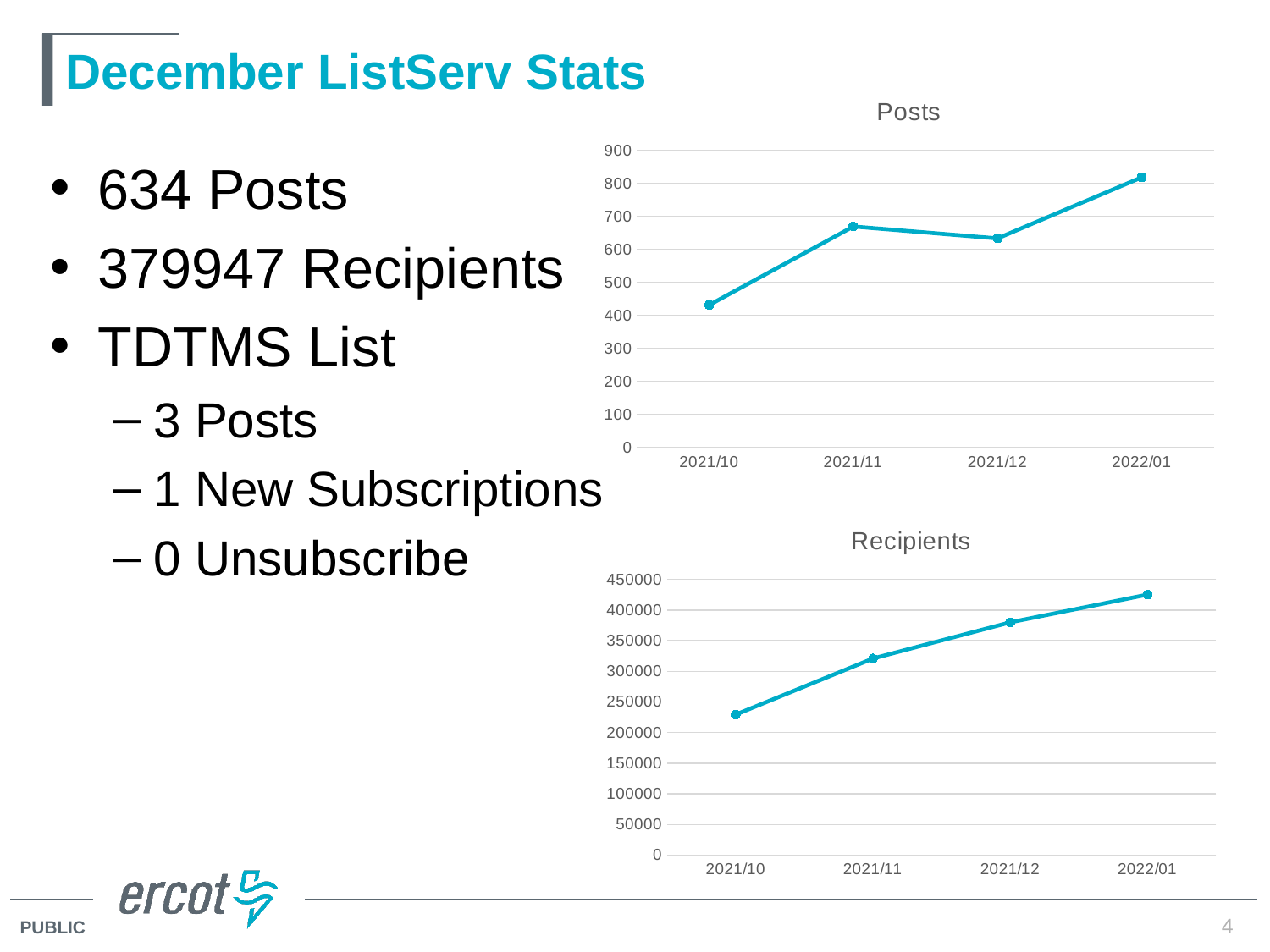
How many data points are plotted in the Recipients chart? 4 What kind of chart is the Recipients chart? line chart What kind of chart is the Posts chart? line chart In the Posts chart, which month has the lowest number of posts? 2021/10 In the Posts chart, is the value for 2022/01 greater or less than 800? greater In the Posts chart, which month has the highest number of posts? 2022/01 In the Recipients chart, which month has the highest number of recipients? 2022/01 In the Recipients chart, which month has the lowest number of recipients? 2021/10 In the Recipients chart, is the value for 2022/01 greater or less than 400000? greater In the Posts chart, is the value for 2021/10 greater or less than 500? less In the Recipients chart, do the values rise or fall from 2021/10 to 2022/01? rise